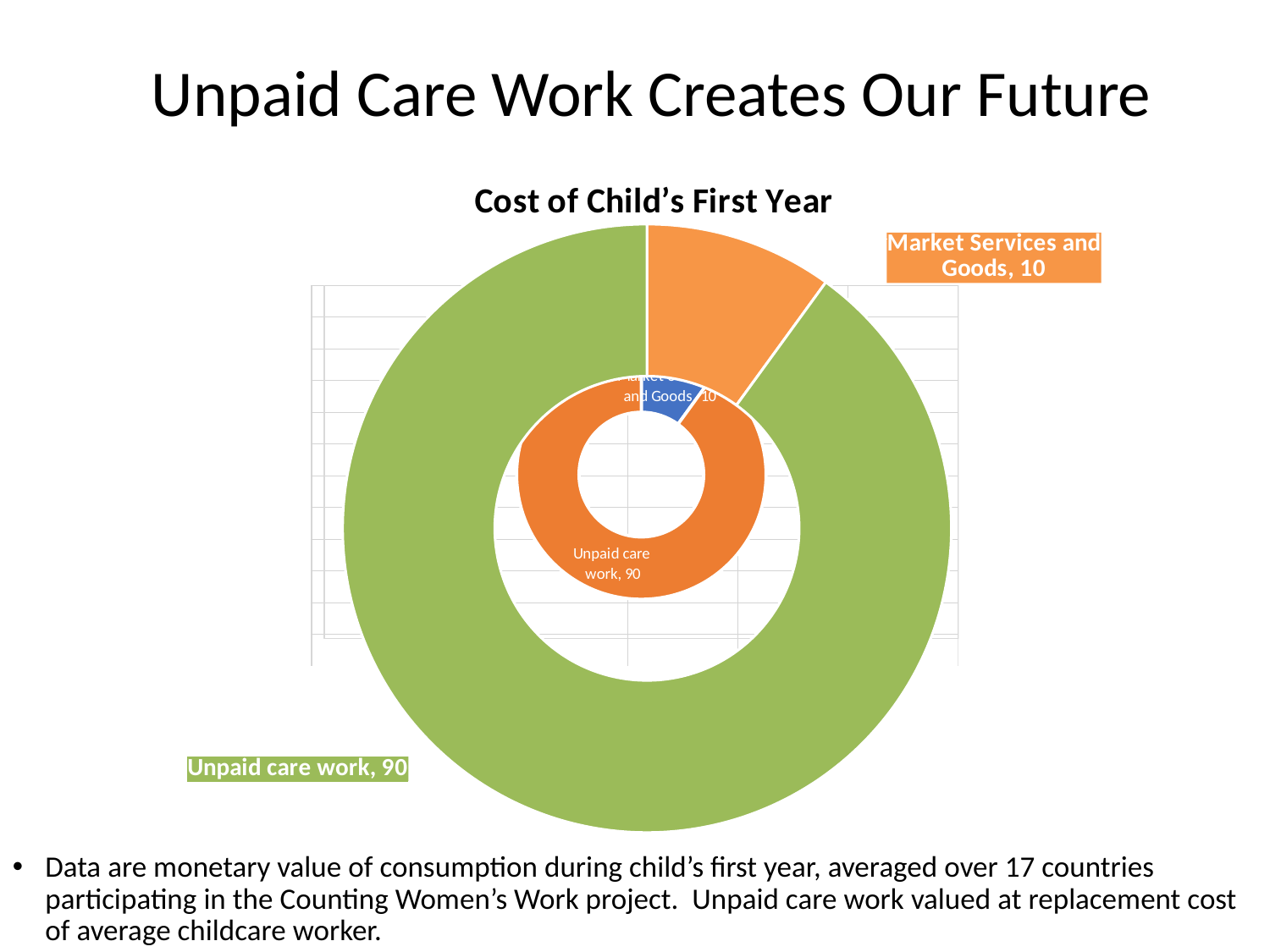
What kind of chart is shown on the slide? Doughnut chart What is the value for Market Services and Goods in the Cost of Child's First Year chart? 10 Which category has the smallest value in the Cost of Child's First Year chart? Market Services and Goods What is the title of the chart on the slide? Cost of Child's First Year What colour is the Unpaid care work segment in the outer ring of the chart? Green What share of the Cost of Child's First Year chart does Unpaid care work represent? 90% What is the difference between the values for Unpaid care work and Market Services and Goods? 80 What is the value for Unpaid care work in the Cost of Child's First Year chart? 90 How many categories are shown in the Cost of Child's First Year chart? 2 Which is larger, Unpaid care work or Market Services and Goods? Unpaid care work What is the total of the values shown in the Cost of Child's First Year chart? 100 Which category has the largest value in the Cost of Child's First Year chart? Unpaid care work